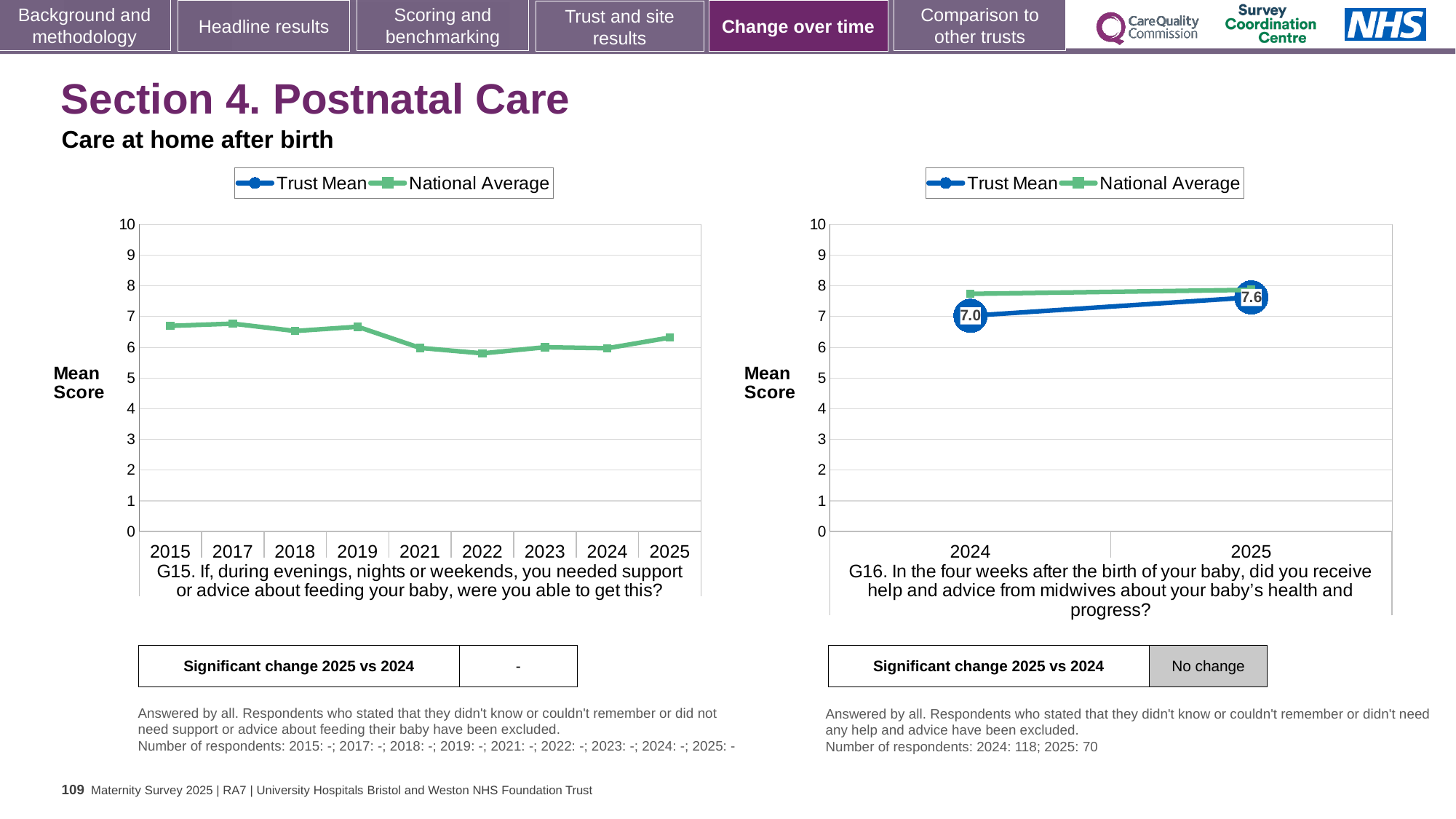
What kind of chart is the G15 chart on the left? line chart On the G16 chart (right), by how much did the Trust Mean change from 2024 to 2025? 0.6 On the G15 chart (left), what is the label on the y axis? Mean Score On the G16 chart (right), what is the Trust Mean score for 2024? 7.0 On the G15 chart (left), how many series does the legend list? 2 On the G15 chart (left), how many years are shown on the x axis? 9 On the G16 chart (right), is the National Average for 2024 greater or less than 7? greater On the G16 chart (right), does the Trust Mean rise or fall from 2024 to 2025? rise On the G15 chart (left), is the National Average for 2015 greater or less than 6? greater On the G16 chart (right), what is the Trust Mean score for 2025? 7.6 On the G16 chart (right), which year has the higher Trust Mean, 2024 or 2025? 2025 On the G16 chart (right), how many years are shown on the x axis? 2